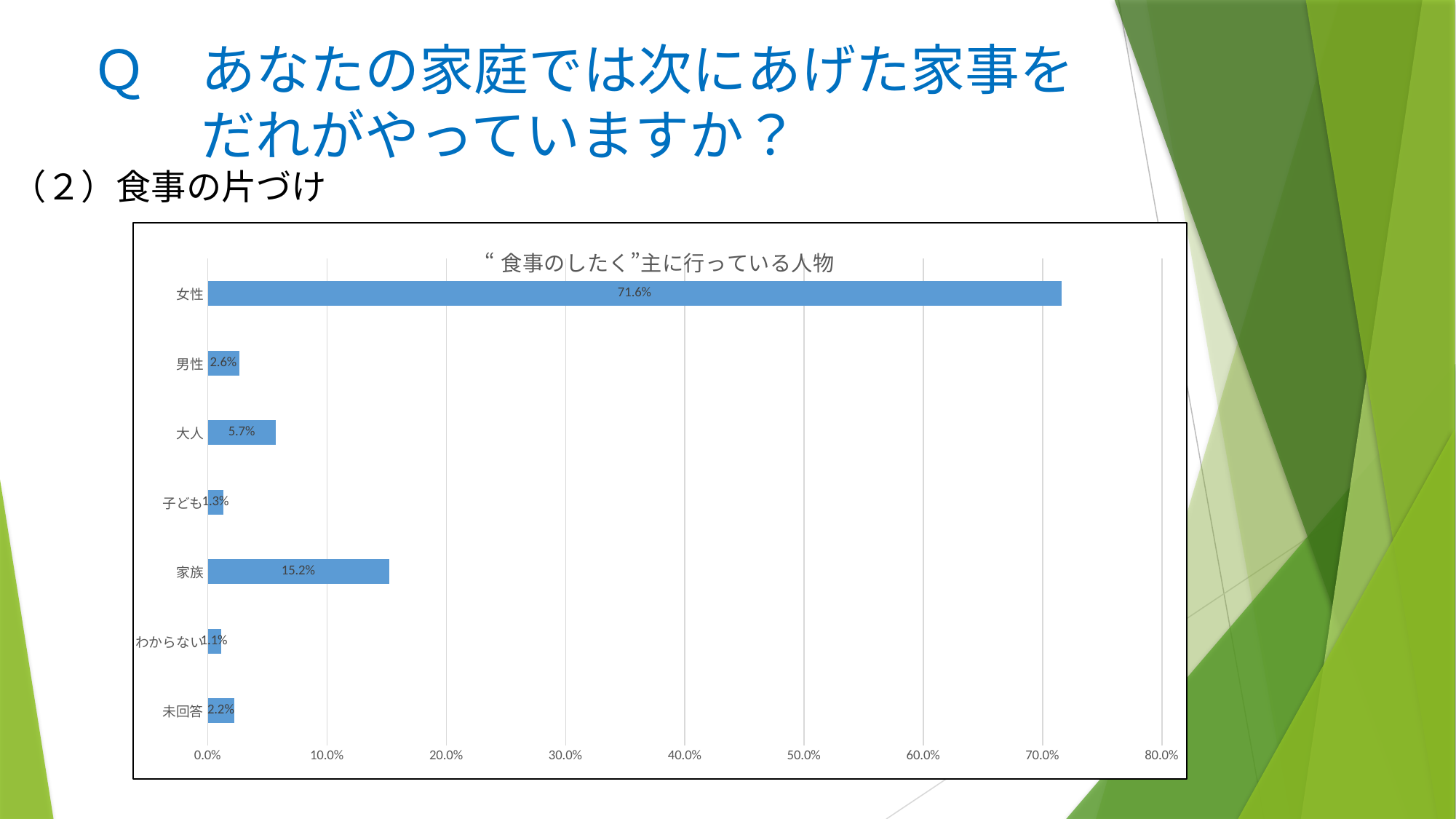
Which category has the lowest value? わからない What is the difference between the values for 女性 and 家族? 56.4% What is the title of the chart? “食事のしたく”主に行っている人物 What is the value for 女性? 71.6% Which is larger, the value for 大人 or the value for 男性? 大人 Is the value for 女性 greater or less than 70.0%? greater What is the value for 家族? 15.2% Which category has the highest value? 女性 How many categories are shown in the chart? 7 What kind of chart is shown on the slide? bar chart What is the value for 男性? 2.6% What is the value for 大人? 5.7%